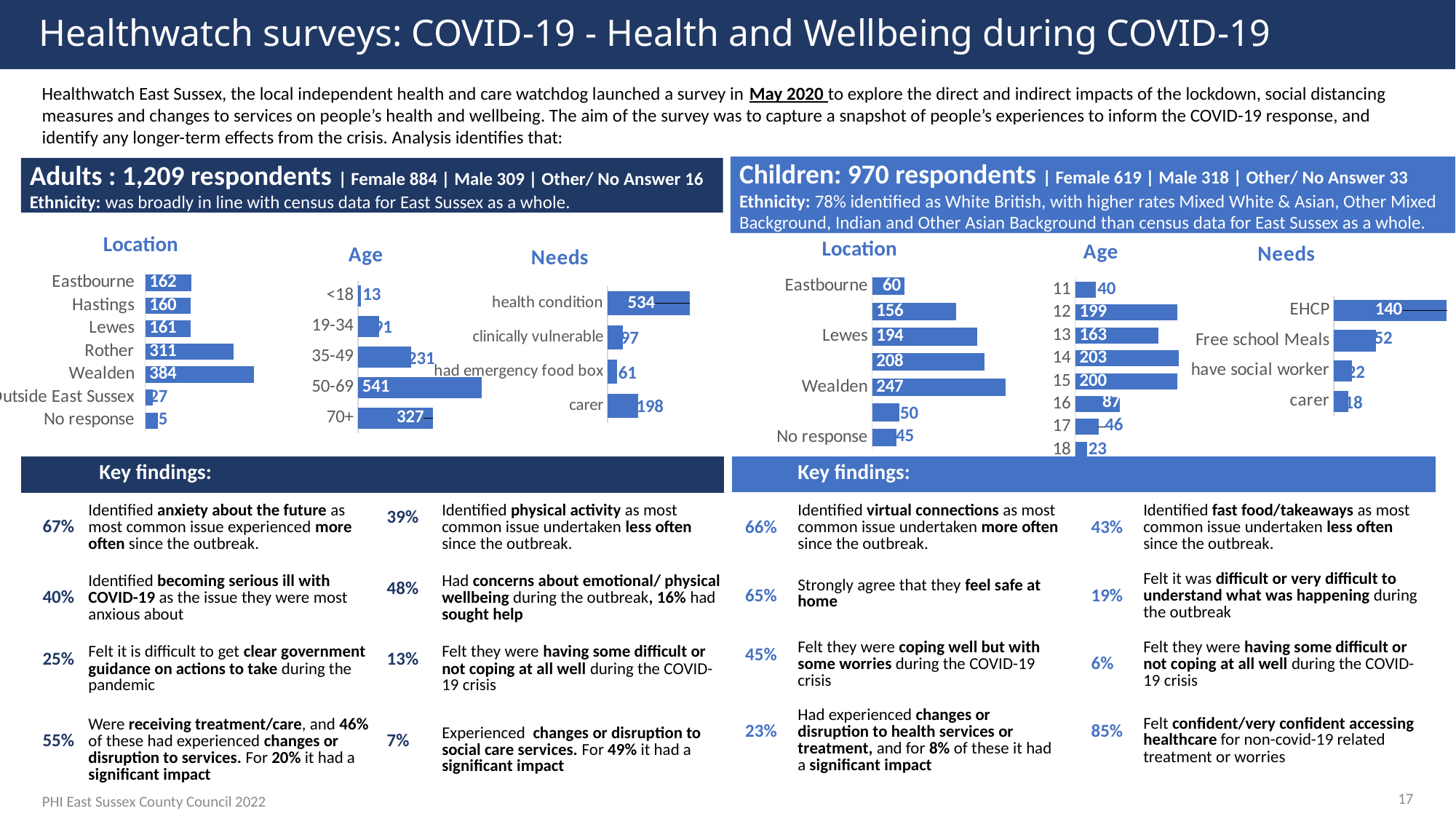
In the Adults Age chart, what is the value for the 50-69 age group? 541 In the Adults Location chart, how many respondents were from Wealden? 384 In the Adults Age chart, what is the difference between the 50-69 and 70+ age groups? 214 In the Adults Location chart, which category has the lowest value? No response In the Children Location chart, how many respondents were from Lewes? 194 In the Adults Location chart, which location has the highest number of respondents? Wealden What type of chart is the Children Needs chart? bar chart In the Adults Needs chart, which is larger: clinically vulnerable or carer? carer In the Adults Needs chart, how many respondents had a health condition? 534 In the Children Age chart, which age has the highest number of respondents? 14 In the Children Needs chart, what is the value for EHCP? 140 In the Children Age chart, how many age categories are shown? 8